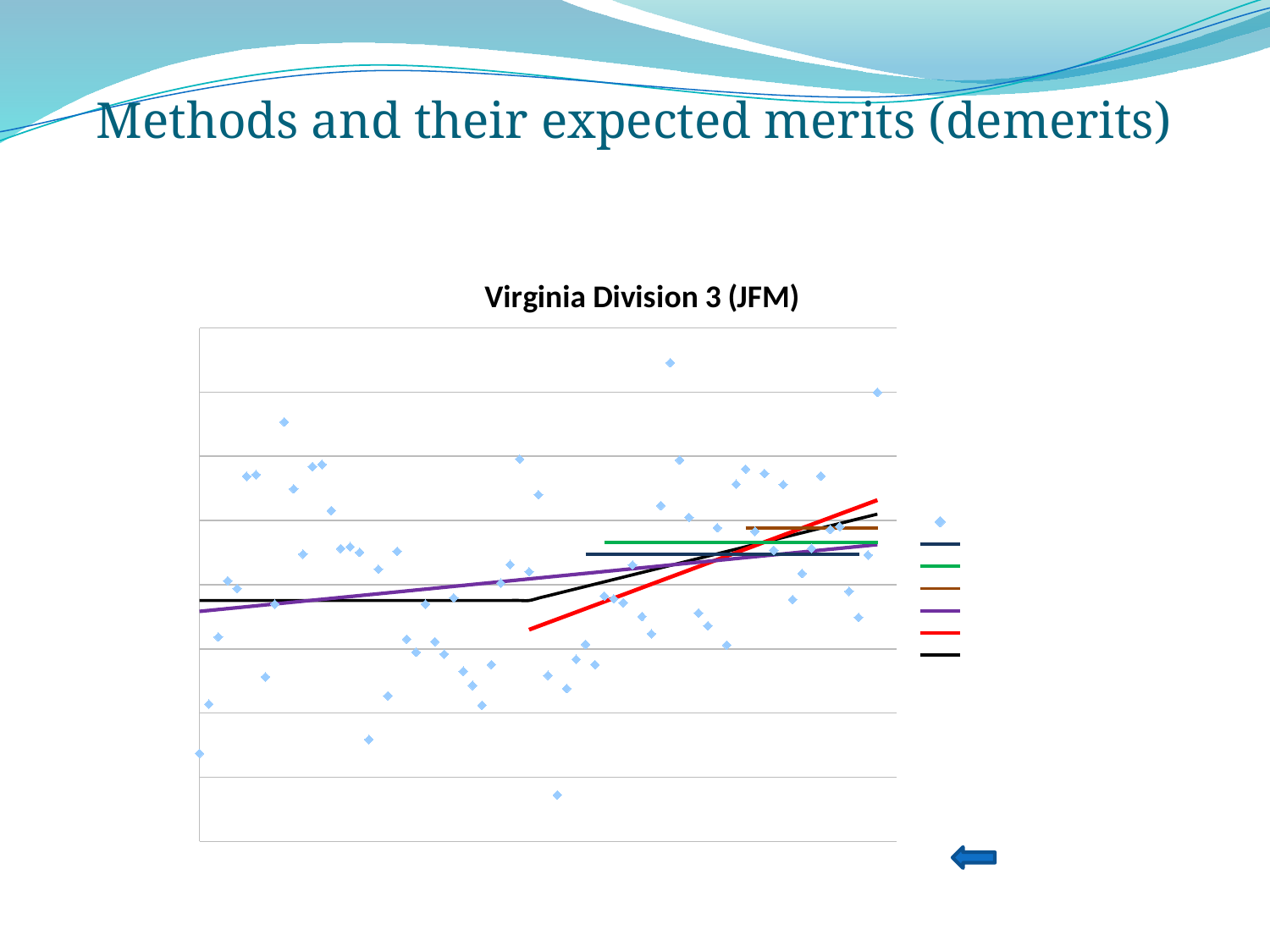
How many entries does the chart's legend show? 6 Which colour is the steepest fitted line on the chart? red What is the title of the chart? Virginia Division 3 (JFM) Does the red fitted line rise or fall from left to right? rise Does the purple fitted line rise or fall from left to right? rise What kind of chart is shown on the slide? scatter chart